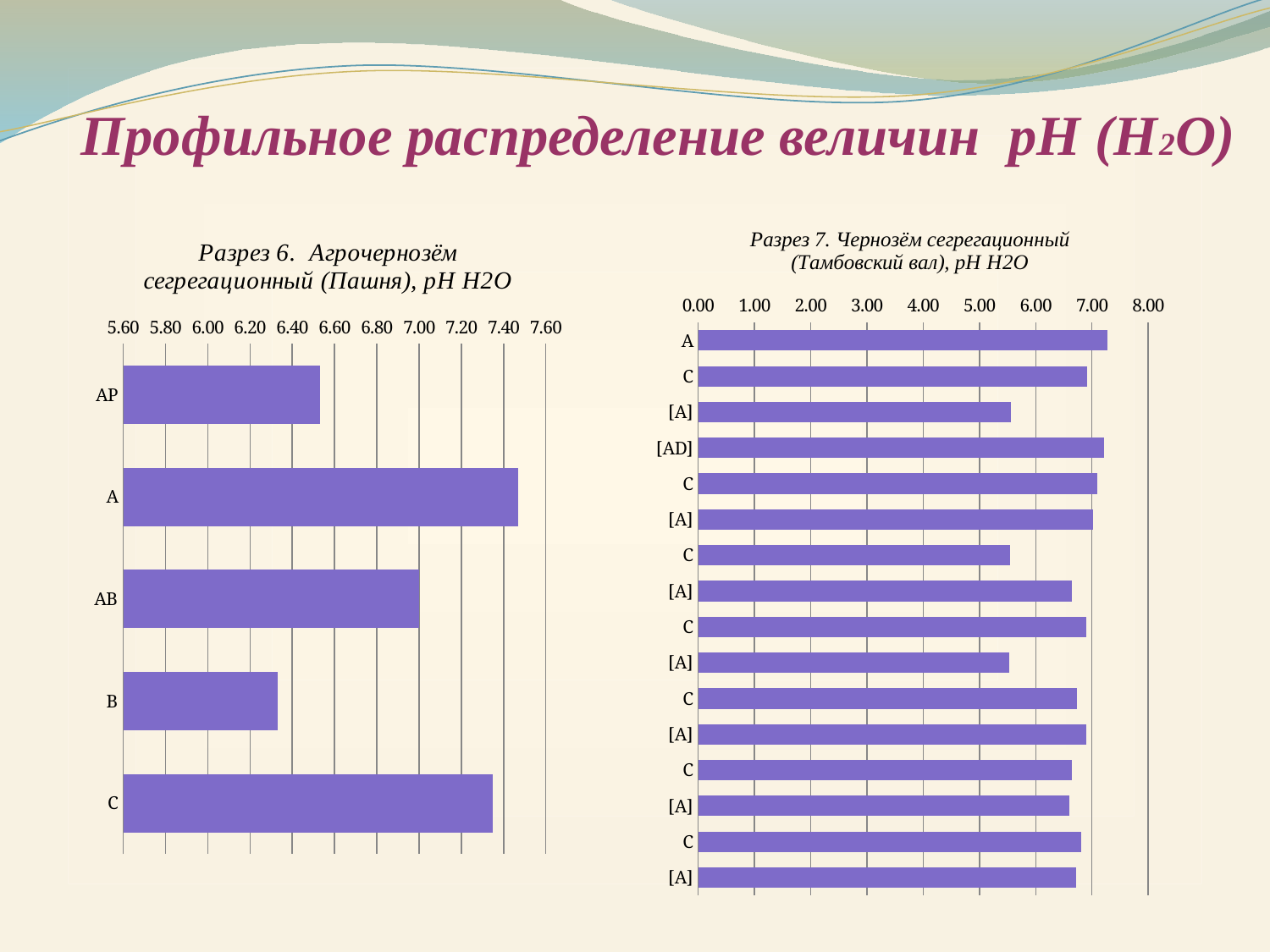
On the left chart, 'Разрез 6', which horizon has the highest pH value? A On the right chart, 'Разрез 7', is the value for the topmost bar, A, greater or less than 7.00? greater On the left chart, 'Разрез 6', which is larger, the value for AP or the value for B? AP What kind of chart is the left chart, 'Разрез 6. Агрочернозём сегрегационный (Пашня), pH H2O'? bar chart On the left chart, 'Разрез 6', is the value for A greater or less than 7.40? greater How many categories are shown on the left chart, 'Разрез 6'? 5 On the left chart, 'Разрез 6', is the value for C greater or less than 7.20? greater On the left chart, 'Разрез 6', which horizon has the lowest pH value? B What is the title of the right chart on the slide? Разрез 7. Чернозём сегрегационный (Тамбовский вал), pH H2O How many bars are shown on the right chart, 'Разрез 7. Чернозём сегрегационный (Тамбовский вал), pH H2O'? 16